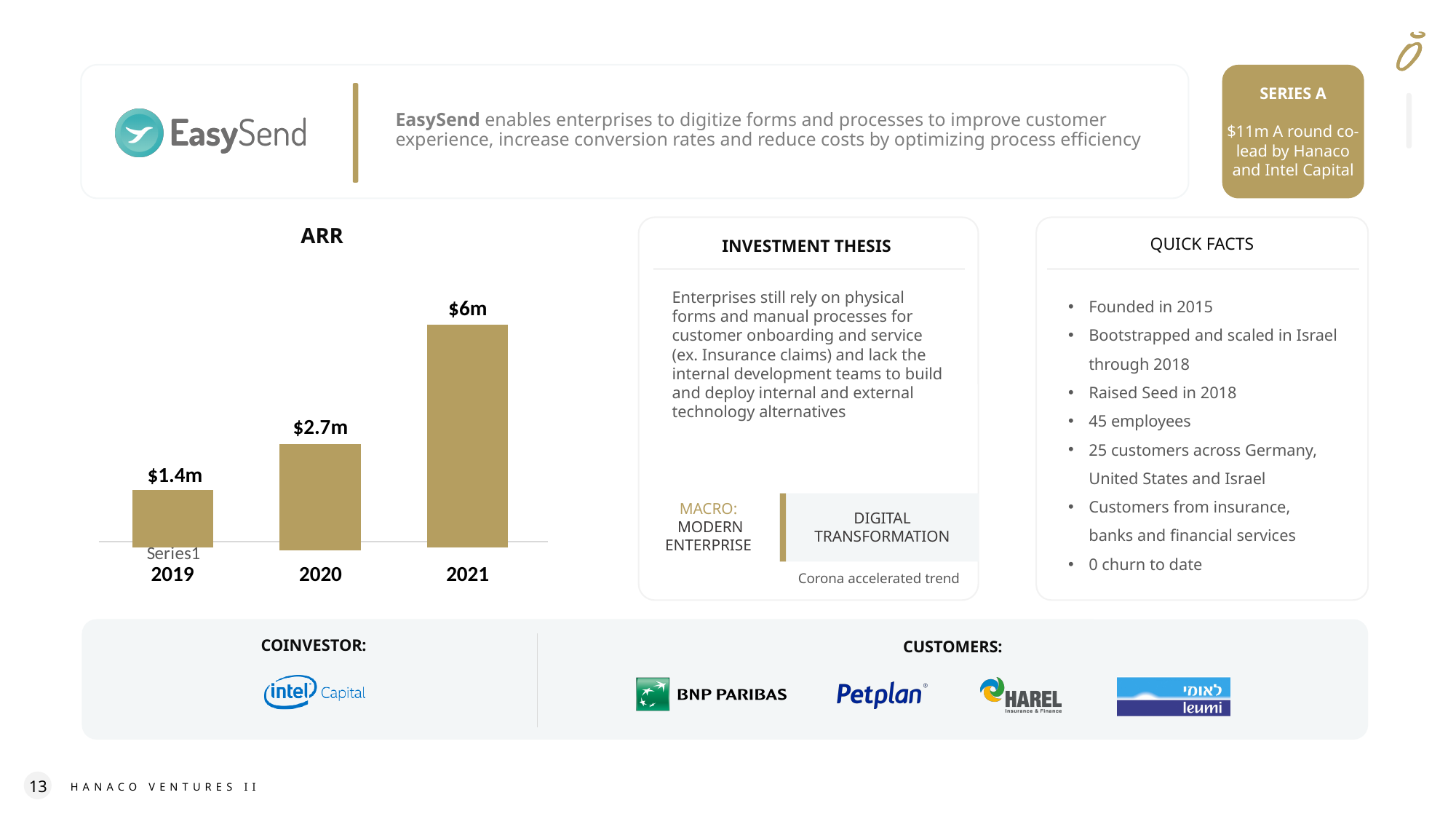
What is the difference in ARR between 2021 and 2020? $3.3m What type of chart is used to show ARR? Bar chart How many years are plotted in the ARR chart? 3 Which year has a larger ARR, 2019 or 2020? 2020 What is the ARR value shown for 2021? $6m Which year has the lowest ARR in the chart? 2019 What is the title of the chart on the slide? ARR Which year has the highest ARR in the chart? 2021 What is the ARR value shown for 2020? $2.7m What is the difference in ARR between 2020 and 2019? $1.3m What is the ARR value shown for 2019? $1.4m Does ARR rise or fall from 2019 to 2021? Rise